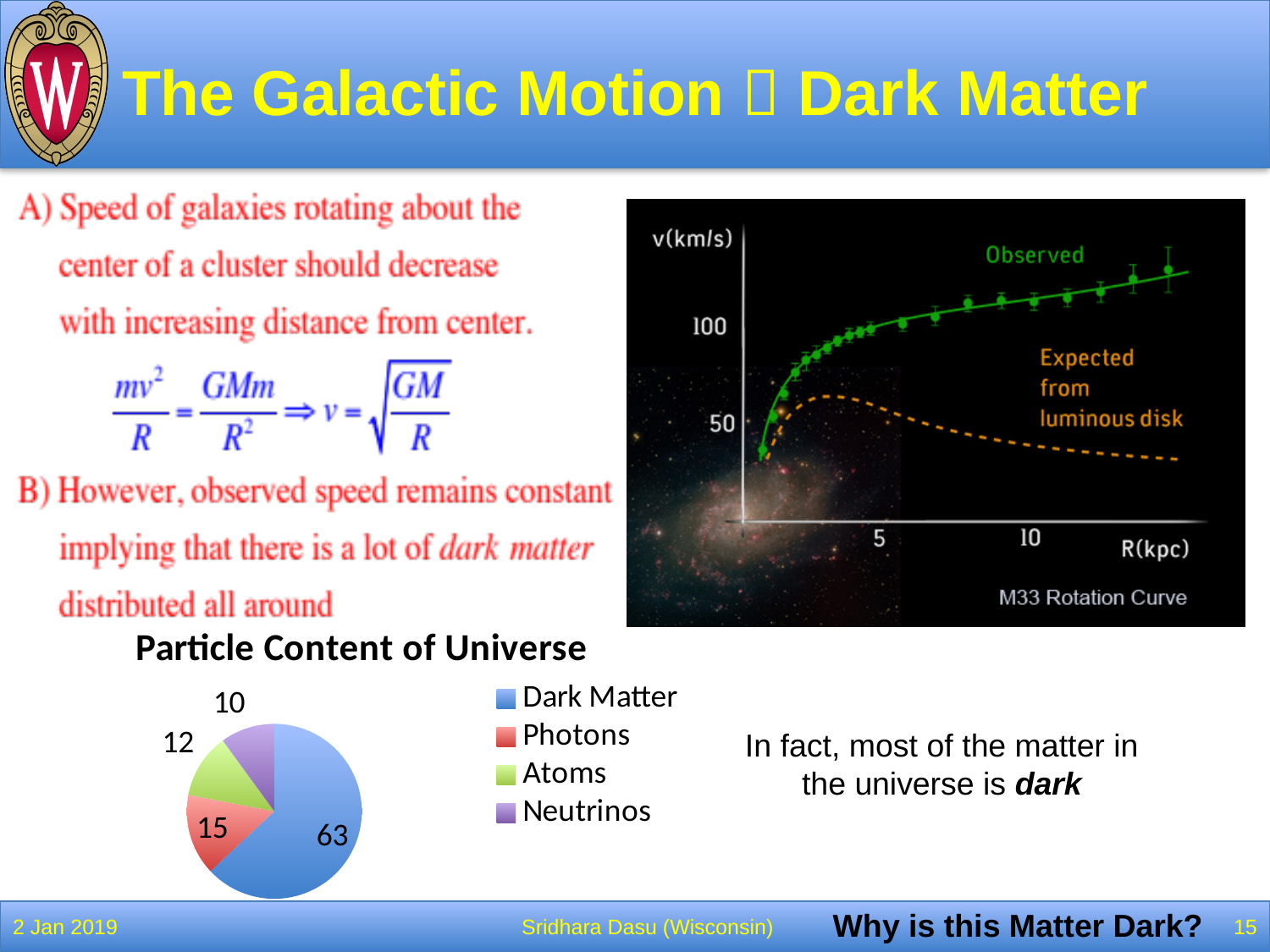
What type of chart is the Particle Content of Universe chart? pie chart In the Particle Content of Universe pie chart, which is larger, Photons or Atoms? Photons In the Particle Content of Universe pie chart, which category has the largest slice? Dark Matter In the Particle Content of Universe pie chart, which category has the smallest slice? Neutrinos How many categories does the Particle Content of Universe pie chart show? 4 In the Particle Content of Universe pie chart, what share of the total does Dark Matter represent? 63% In the Particle Content of Universe pie chart, what is the value for Photons? 15 In the Particle Content of Universe pie chart, what is the value for Neutrinos? 10 In the Particle Content of Universe pie chart, what is the difference between the Dark Matter value and the Atoms value? 51 In the M33 Rotation Curve chart, does the Expected from luminous disk curve rise or fall as R increases beyond about 5 kpc? fall In the Particle Content of Universe pie chart, what is the value for Dark Matter? 63 In the M33 Rotation Curve chart, is the Observed velocity at R = 10 kpc greater or less than 100 km/s? greater